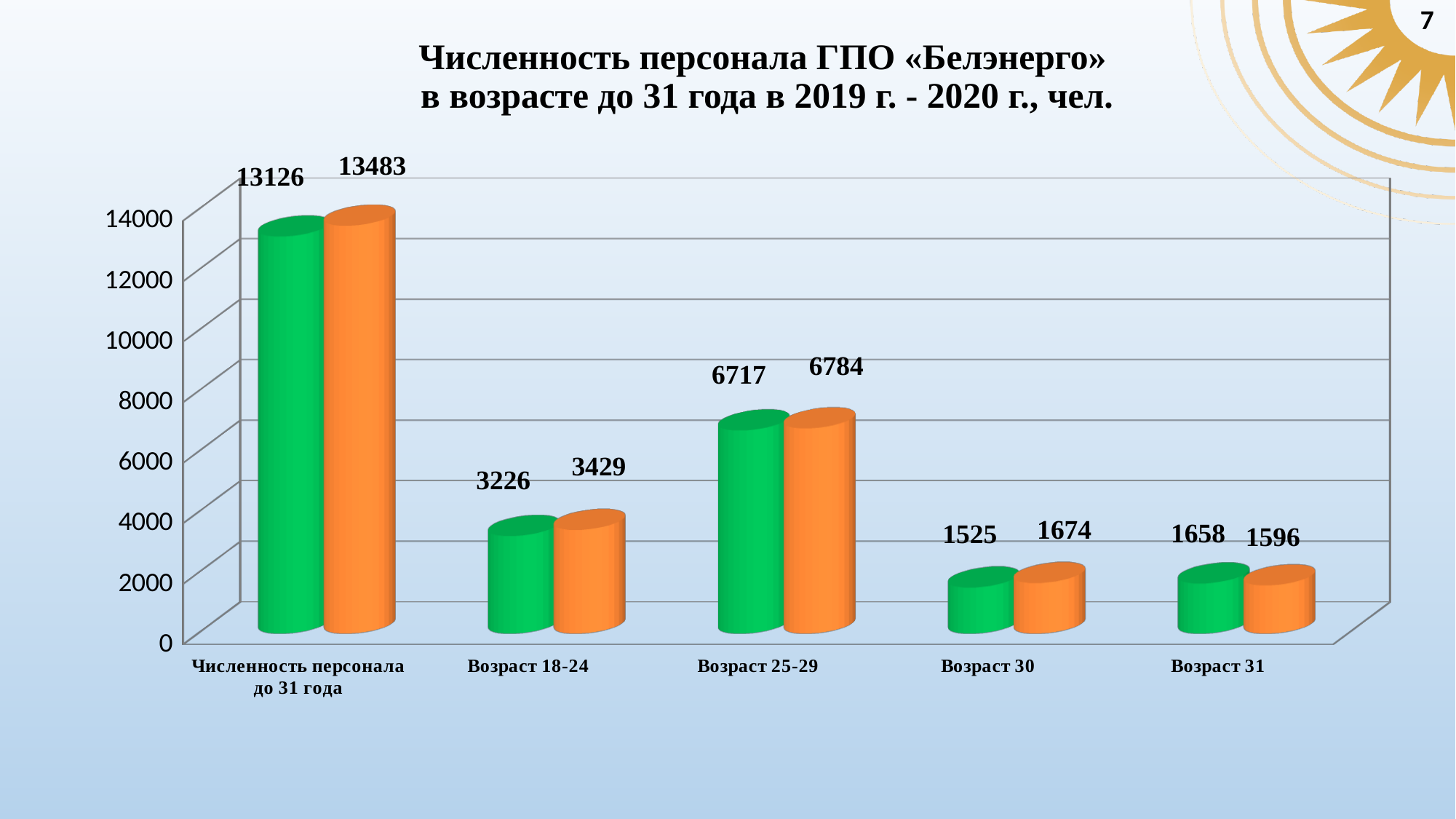
How many categories are shown on the x axis? 5 For "Возраст 31", which bar is larger, the green one or the orange one? green What is the value of the orange bar for "Возраст 25-29"? 6784 What is the value of the orange bar for "Численность персонала до 31 года"? 13483 Which category has the lowest orange bar? Возраст 31 Which category has the highest green bar? Численность персонала до 31 года What is the difference between the orange and green bars for "Возраст 30"? 149 What is the difference between the orange and green bars for "Численность персонала до 31 года"? 357 What is the value of the green bar for "Возраст 18-24"? 3226 What kind of chart is shown on the slide? bar chart What is the value of the green bar for "Возраст 31"? 1658 What is the title of the chart? Численность персонала ГПО «Белэнерго» в возрасте до 31 года в 2019 г. - 2020 г., чел.